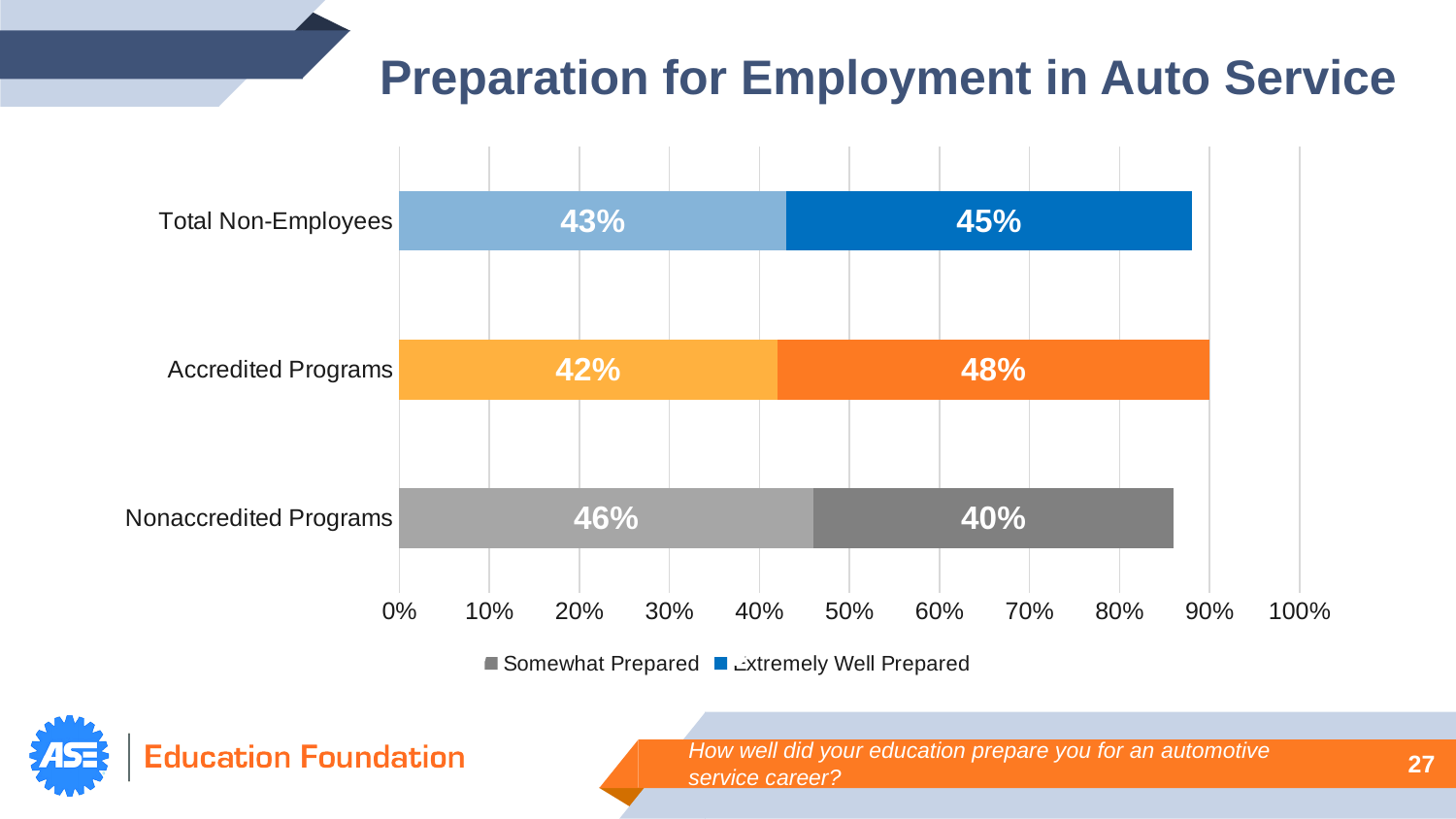
What is the combined total of the two segments for the Accredited Programs bar? 90% How many categories are shown on the chart? 3 What is the difference between the Extremely Well Prepared values for Accredited Programs and Nonaccredited Programs? 8% Which category has the lowest Somewhat Prepared percentage? Accredited Programs What is the combined total of the two segments for the Nonaccredited Programs bar? 86% What is the Somewhat Prepared value for Nonaccredited Programs? 46% What type of chart is shown on the slide? Stacked bar chart Which category has the highest Extremely Well Prepared percentage? Accredited Programs How many series does the legend list? 2 What is the Extremely Well Prepared value for Total Non-Employees? 45% For Nonaccredited Programs, which is larger: Somewhat Prepared or Extremely Well Prepared? Somewhat Prepared What percentage of Accredited Programs respondents said they were Extremely Well Prepared? 48%